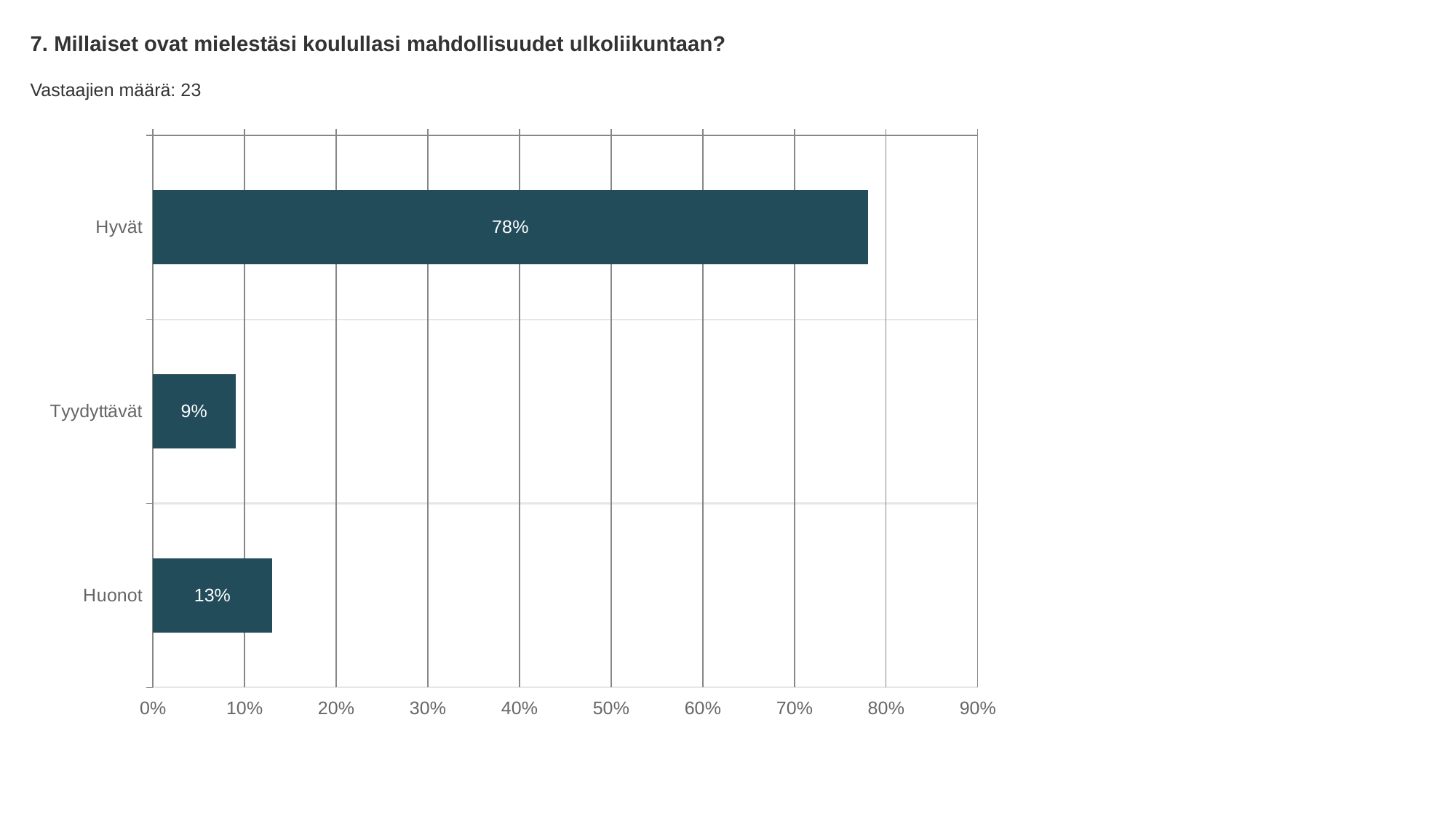
How many categories are shown in the chart? 3 Which category has the lowest value? Tyydyttävät Is the value for Hyvät greater or less than 70%? greater What is the value for Huonot? 13% What is the value for Tyydyttävät? 9% What is the value for Hyvät? 78% What is the difference between the values for Hyvät and Huonot? 65% What is the difference between the values for Huonot and Tyydyttävät? 4% Which is larger, the value for Huonot or the value for Tyydyttävät? Huonot How many respondents (Vastaajien määrä) are reported on the slide? 23 Which category has the highest value? Hyvät What kind of chart is shown on the slide? bar chart